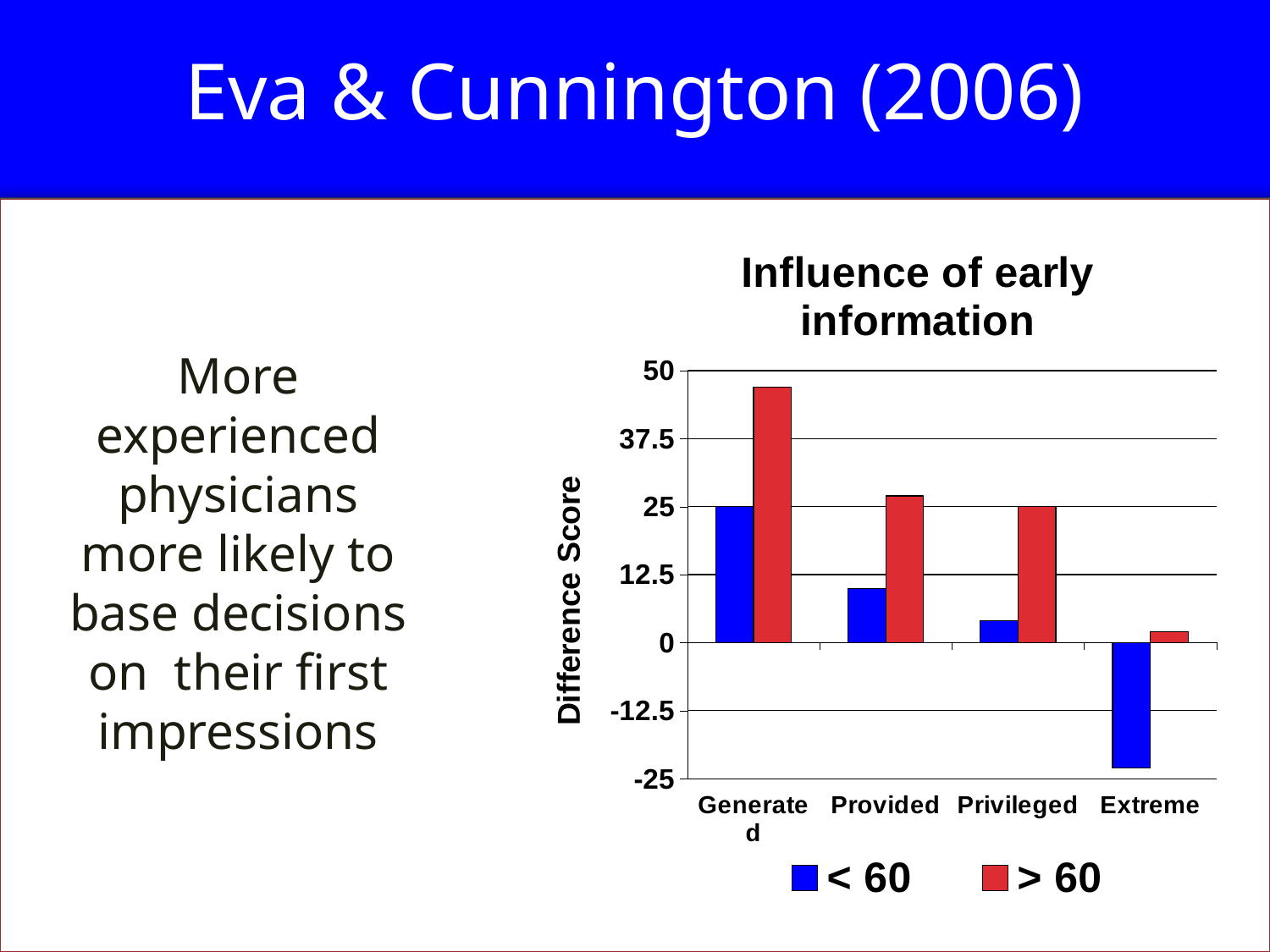
What type of chart is shown on the slide? bar chart How many categories are shown on the x axis of the chart? 4 What is the label on the vertical axis of the chart? Difference Score Is the value for the > 60 series in the Generated category greater or less than 37.5? greater What is the value for the < 60 series in the Generated category? 25 What is the title of the chart? Influence of early information Which category has the lowest value for the < 60 series? Extreme Which is larger: the > 60 value for Provided or the > 60 value for Generated? Generated What is the value for the > 60 series in the Privileged category? 25 How many series does the chart's legend list? 2 Which category has the highest value for the > 60 series? Generated Is the value for the < 60 series in the Extreme category greater or less than -12.5? less